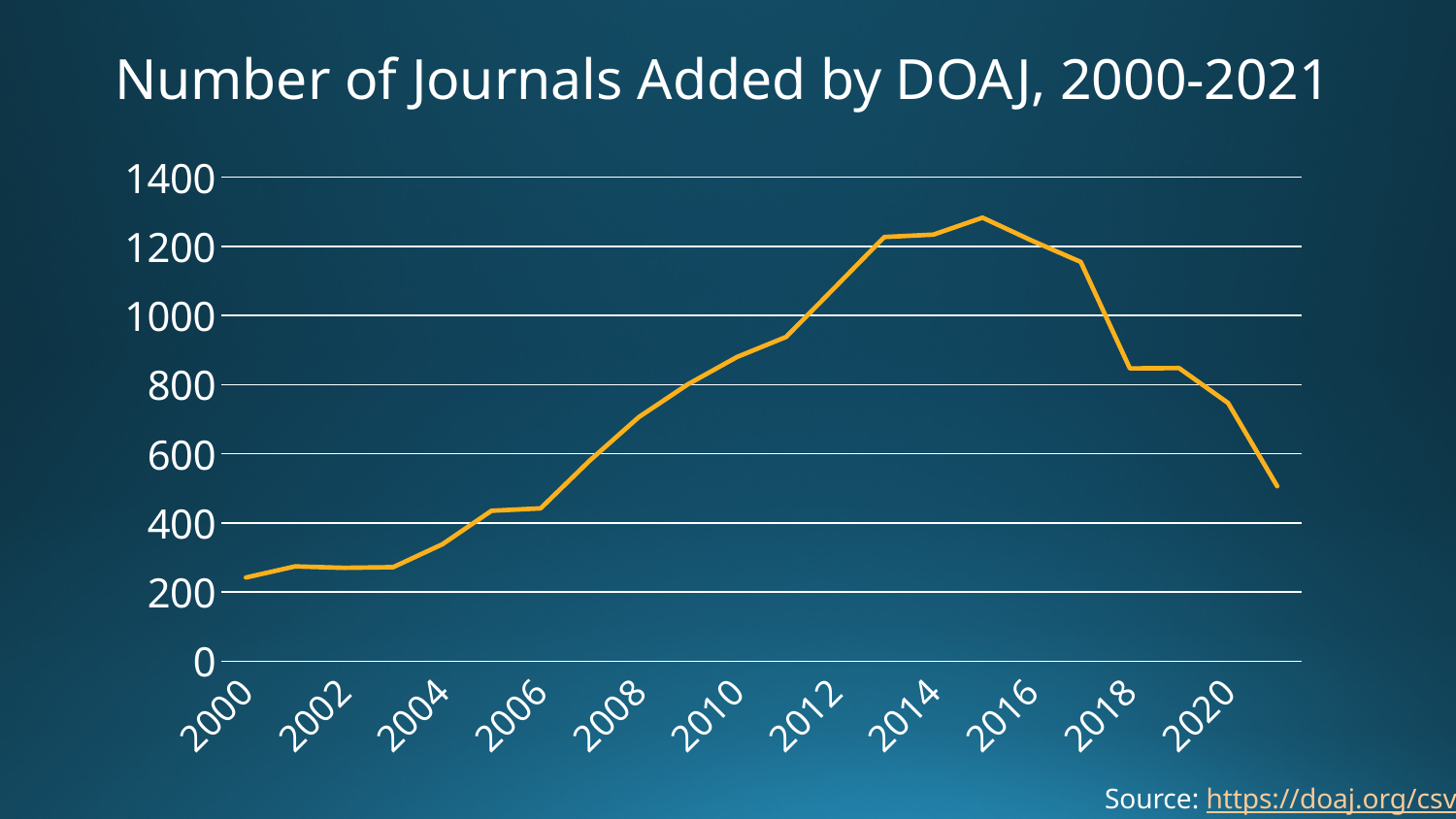
Is the value for 2021 greater or less than 600? less What kind of chart is shown on the slide? line chart Is the value for 2015 greater or less than 1200? greater Which year has the larger value, 2010 or 2020? 2010 Is the value for 2000 greater or less than 200? greater In which year is the number of journals added the lowest? 2000 What is the title of the chart? Number of Journals Added by DOAJ, 2000-2021 Does the number of journals added rise or fall between 2015 and 2021? fall In which year does the line reach its highest value? 2015